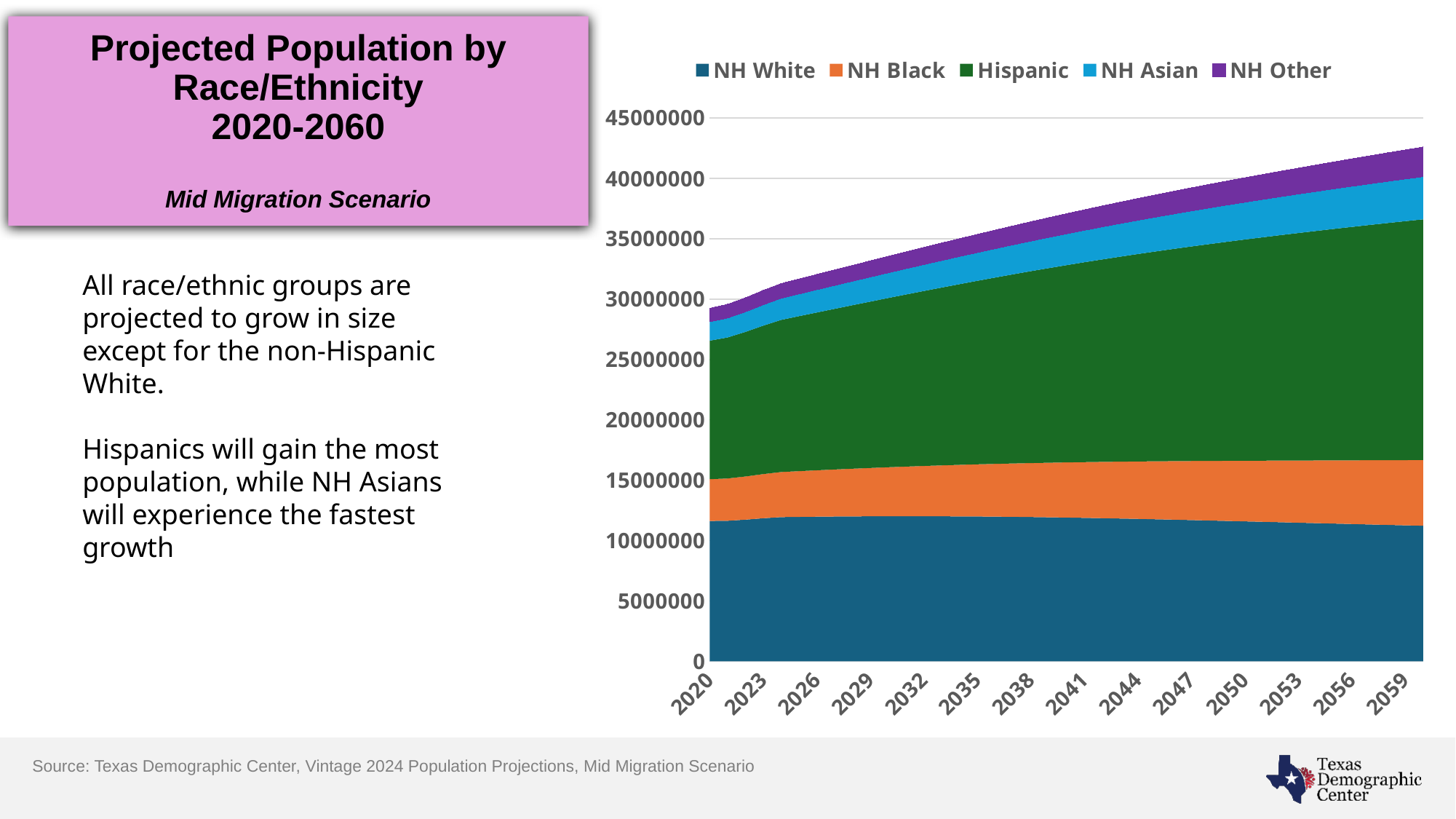
Is the NH White population in 2020 greater or less than 15000000? less Does the total projected population rise or fall from 2020 to 2059? Rise What kind of chart is shown on the slide? Stacked area chart Which series is listed first in the legend? NH White How many year labels are shown on the x axis? 14 Which race/ethnic group has the smallest projected population in 2059? NH Other Is the total projected population in 2059 greater or less than 40000000? greater What colour represents the Hispanic series? Green In 2059, which group has the larger projected population, Hispanic or NH White? Hispanic How many series does the legend list? 5 Is the total projected population in 2020 greater or less than 30000000? less Which race/ethnic group has the largest projected population in 2059? Hispanic